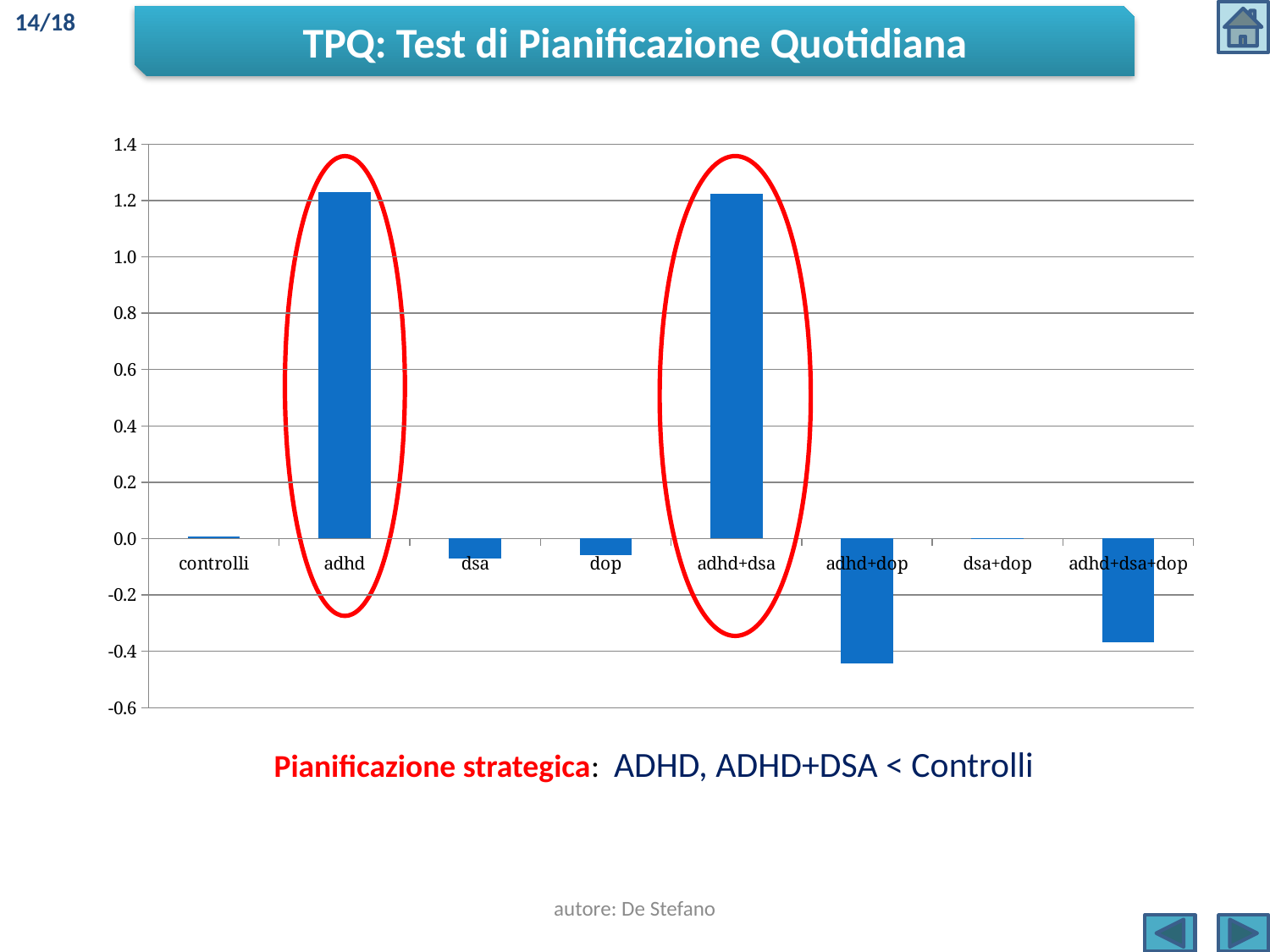
What kind of chart is shown on the slide? bar chart What is the title shown at the top of the slide above the chart? TPQ: Test di Pianificazione Quotidiana Is the value for dsa greater or less than 0.0? less Which category has the lowest value in the chart? adhd+dop Is the value for adhd+dsa greater or less than 1.0? greater Which is larger, the value for adhd+dsa or the value for adhd+dop? adhd+dsa How many categories are shown on the x axis of the chart? 8 Is the value for adhd+dop greater or less than -0.2? less Which is larger, the value for adhd or the value for dsa? adhd Which two categories are circled in red on the chart? adhd and adhd+dsa